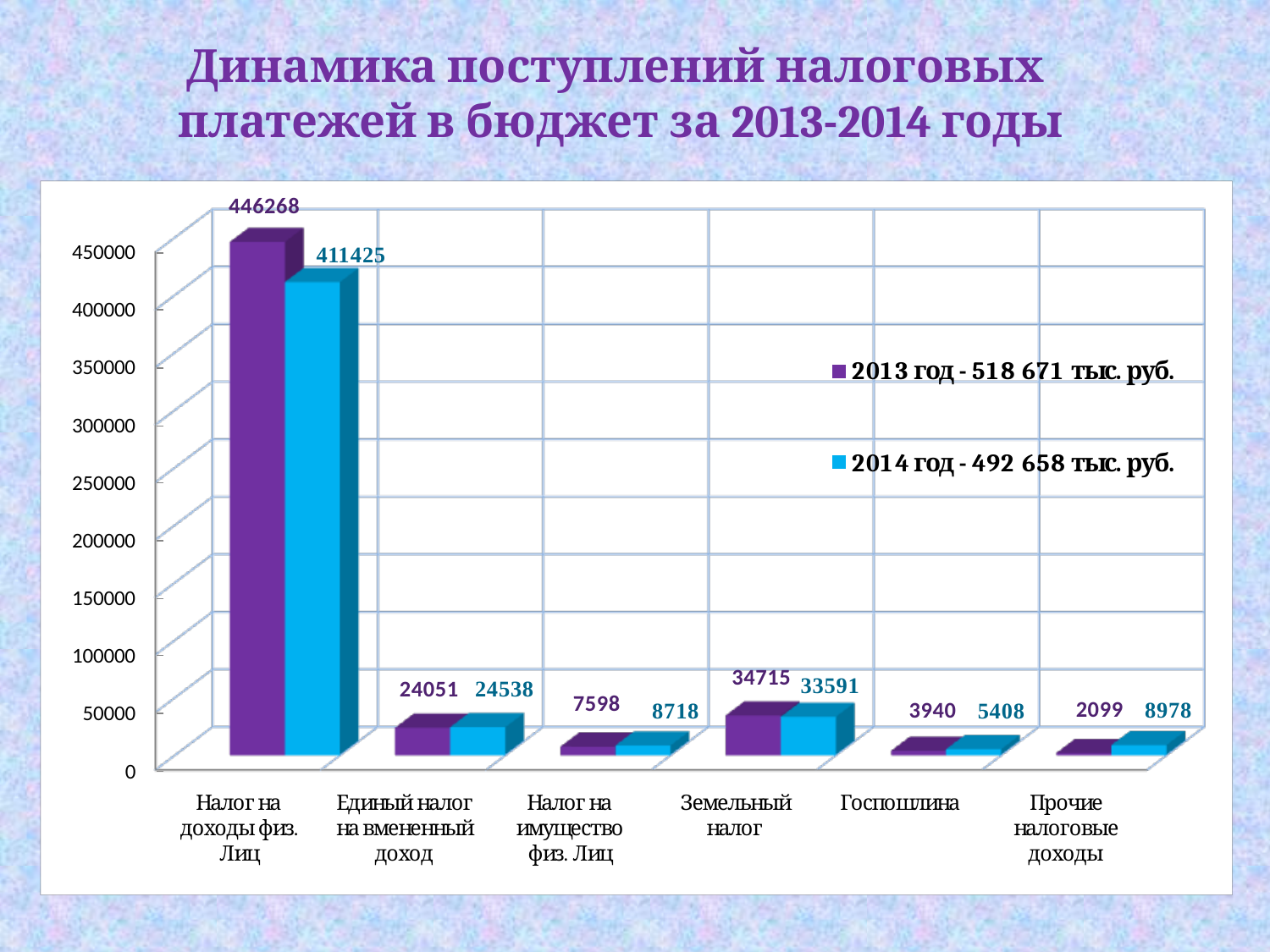
What is the 2013 value for Земельный налог? 34715 For Единый налог на вмененный доход, which year has the larger value, 2013 or 2014? 2014 What is the 2014 value for Госпошлина? 5408 Which category has the lowest 2013 value? Прочие налоговые доходы What is the 2013 value for Налог на доходы физ. Лиц? 446268 What is the 2014 value for Прочие налоговые доходы? 8978 What type of chart is shown on the slide? Bar chart What is the difference between the 2013 and 2014 values for Налог на доходы физ. Лиц? 34843 How many categories are shown on the x axis? 6 Which category has the highest 2014 value? Налог на доходы физ. Лиц Is the 2014 value for Налог на доходы физ. Лиц greater or less than 400000? greater How many series does the legend list? 2